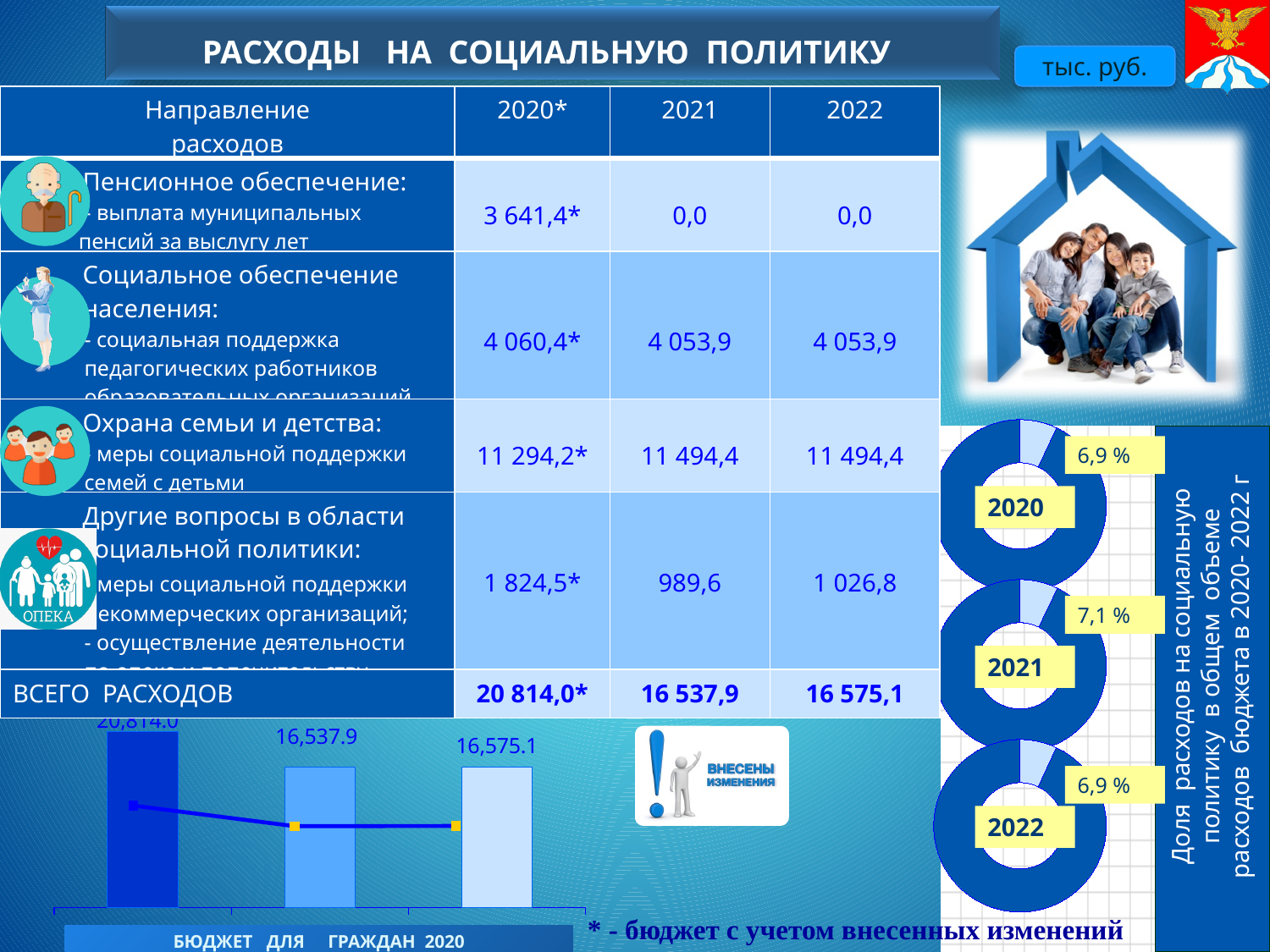
In the bar chart at the bottom left, which bar has the lowest labelled value? The middle bar (16,537.9) Among the donut charts on the right, which year shows the highest share? 2021 What kind of chart is shown at the bottom left of the slide? Bar chart (with a line overlaid) In the donut charts on the right, what share is shown for 2020? 6,9 % In the bar chart at the bottom left, what value is labelled on the middle bar? 16,537.9 In the bar chart at the bottom left, what value is labelled on the right-hand bar? 16,575.1 In the bar chart at the bottom left, which bar is the tallest? The left bar In the bar chart at the bottom left, does the value fall or rise from the left bar to the middle bar? Fall How many bars are shown in the bar chart at the bottom left? 3 In the bar chart at the bottom left, which is larger: the middle bar or the right-hand bar? The right-hand bar (16,575.1) In the donut charts on the right, what share is shown for 2021? 7,1 % In the bar chart at the bottom left, what is the difference between the right-hand bar (16,575.1) and the middle bar (16,537.9)? 37.2